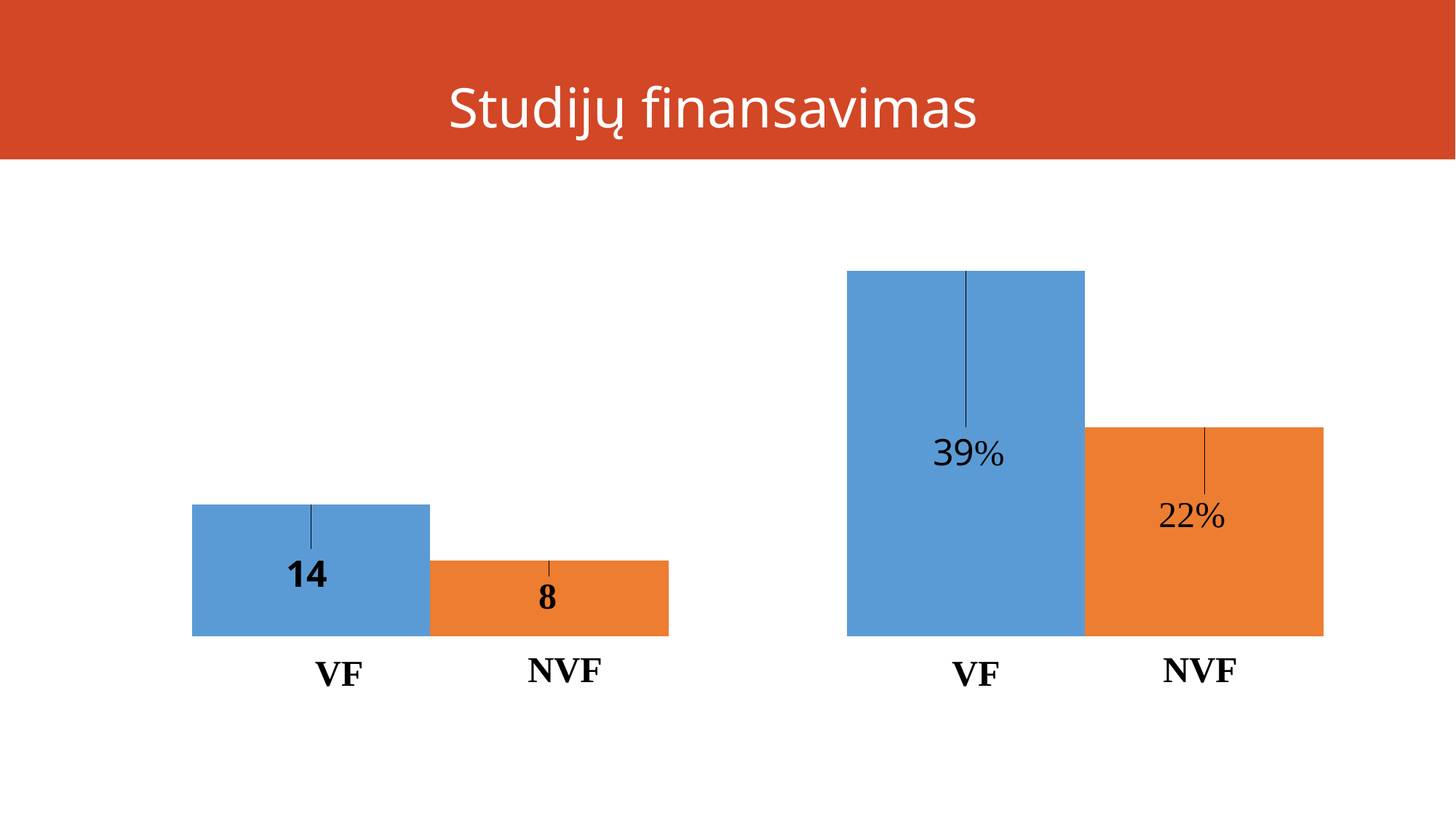
In the left chart, what is the difference between the values for VF and NVF? 6 How many categories does the left chart show? 2 In the left chart, what is the value for NVF? 8 In the right chart, what is the value for VF? 39% In the left chart, what is the value for VF? 14 In the left chart, which category has the highest value? VF In the right chart, what is the difference between the values for VF and NVF? 17% In the right chart, which is larger, the value for VF or the value for NVF? VF In the right chart, what is the value for NVF? 22% What kind of chart is the right chart? bar chart In the right chart, which category has the lowest value? NVF What is the title of the slide? Studijų finansavimas